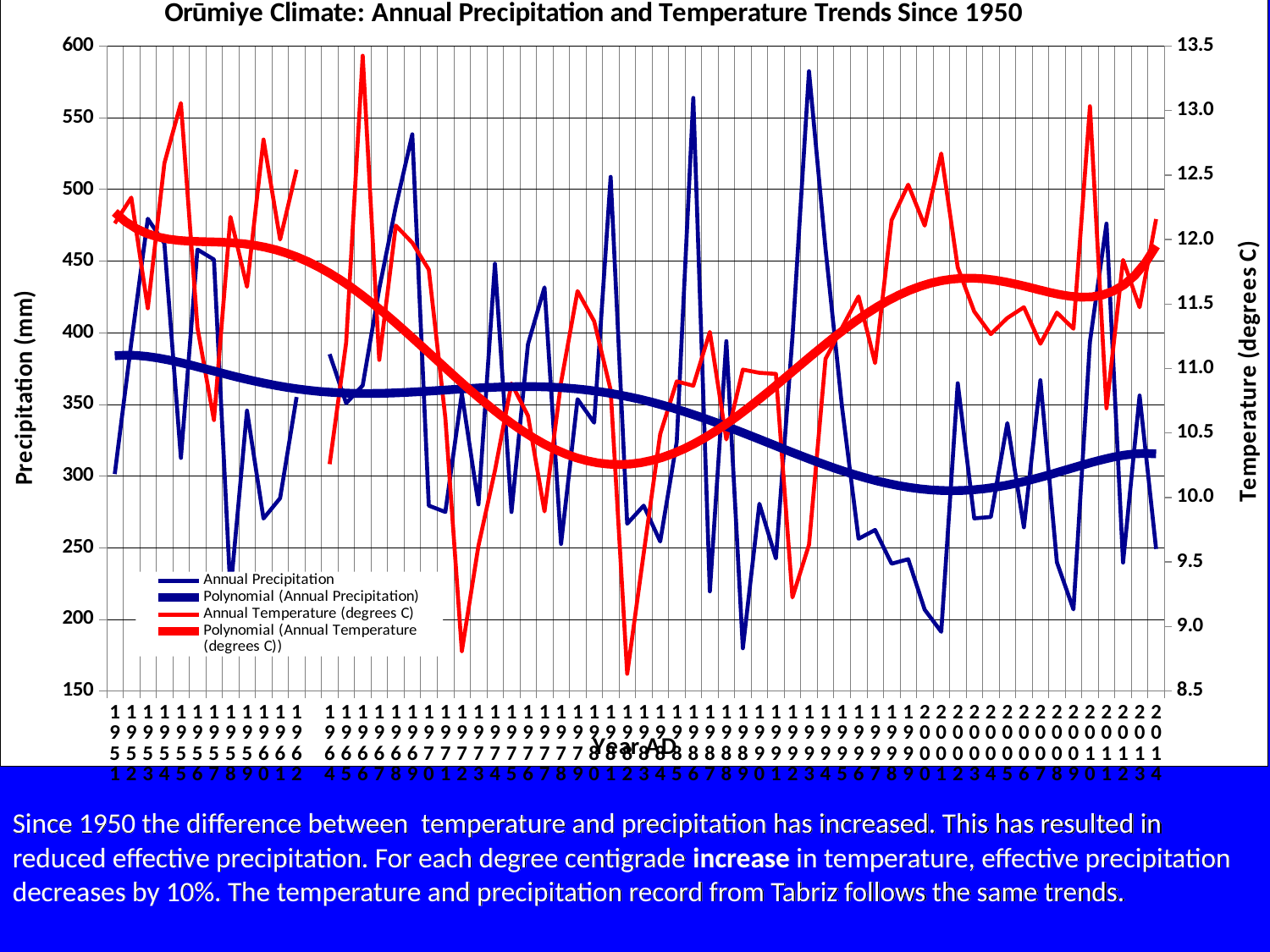
What is the label of the left vertical axis? Precipitation (mm) Is the Annual Temperature (degrees C) value for 1972 greater or less than 9.0? less Is the Annual Precipitation value for 1992 greater or less than 500? less What is the title of the chart? Orūmiye Climate: Annual Precipitation and Temperature Trends Since 1950 Is the Annual Precipitation value for 1986 greater or less than 500? greater Does the Polynomial (Annual Temperature (degrees C)) trend line rise or fall between 1981 and 2005? rise How many series does the legend list? 4 Does the Polynomial (Annual Precipitation) trend line rise or fall between 1951 and 2005? fall What kind of chart is shown on the slide? Line chart